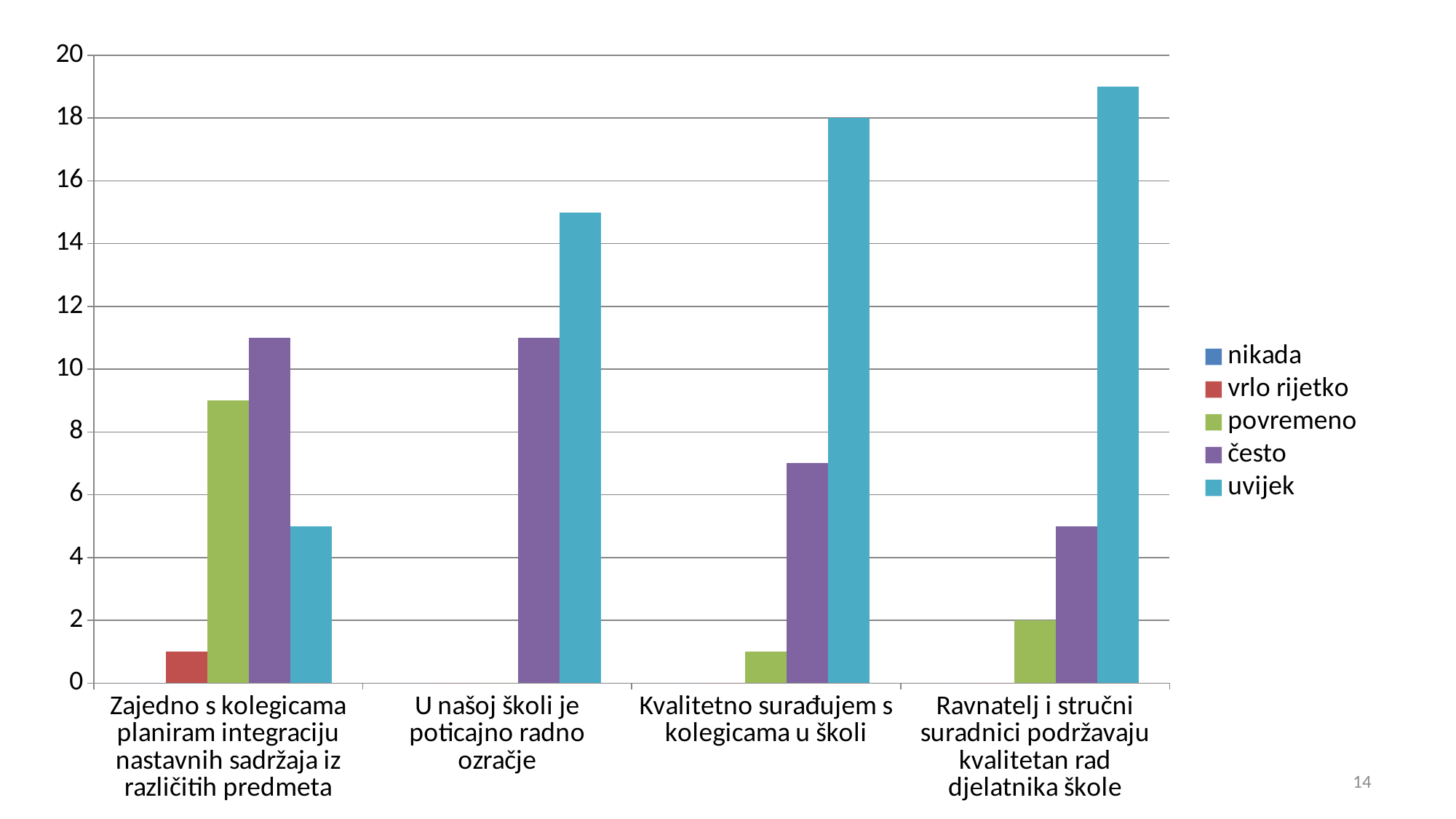
For 'Zajedno s kolegicama planiram integraciju nastavnih sadržaja iz različitih predmeta', which is larger: 'povremeno' or 'uvijek'? povremeno Is the 'uvijek' value for 'U našoj školi je poticajno radno ozračje' greater or less than 14? greater Which category has the lowest 'uvijek' value? Zajedno s kolegicama planiram integraciju nastavnih sadržaja iz različitih predmeta How many categories are shown on the x axis? 4 What is the value of 'povremeno' for 'Ravnatelj i stručni suradnici podržavaju kvalitetan rad djelatnika škole'? 2 Is the 'često' value for 'Kvalitetno surađujem s kolegicama u školi' greater or less than 8? less Is the 'često' value for 'Zajedno s kolegicama planiram integraciju nastavnih sadržaja iz različitih predmeta' greater or less than 10? greater What kind of chart is shown on the slide? bar chart What is the value of 'uvijek' for 'Kvalitetno surađujem s kolegicama u školi'? 18 Which category has the highest 'uvijek' value? Ravnatelj i stručni suradnici podržavaju kvalitetan rad djelatnika škole Which legend entry is shown in red? vrlo rijetko How many series does the legend list? 5